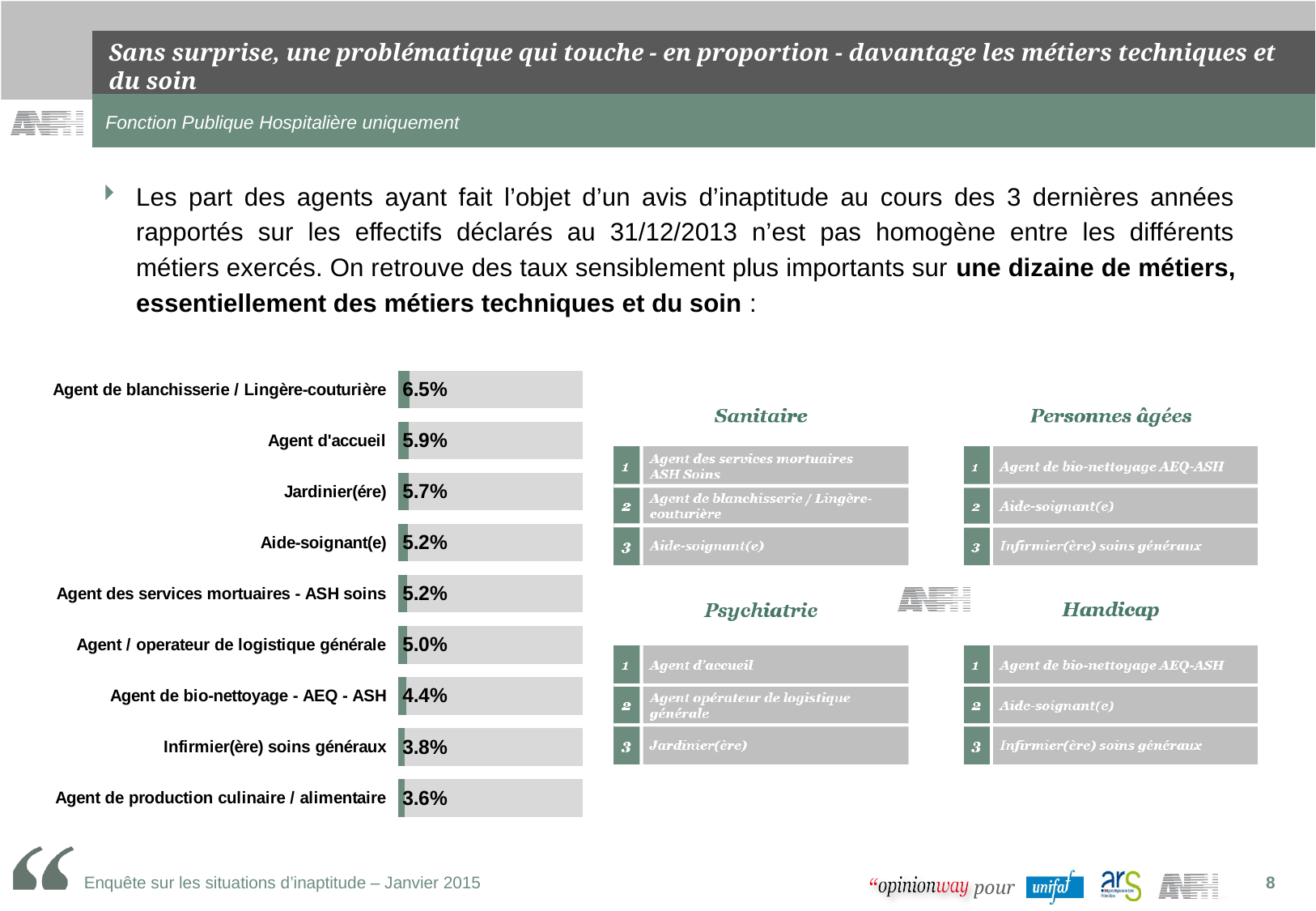
Which category has the lowest value in the bar chart? Agent de production culinaire / alimentaire Which category has the highest value in the bar chart? Agent de blanchisserie / Lingère-couturière Which has a larger value, Agent d'accueil or Aide-soignant(e)? Agent d'accueil How many categories are shown in the bar chart? 9 What is the value shown for Infirmier(ère) soins généraux? 3.8% What is the difference between the values for Jardinier(ére) and Infirmier(ère) soins généraux? 1.9% What is the difference between the values for Agent de blanchisserie / Lingère-couturière and Agent de production culinaire / alimentaire? 2.9% What is the value shown for Agent de blanchisserie / Lingère-couturière? 6.5% What is the value shown for Agent d'accueil? 5.9% Do the values in the bar chart increase or decrease from the top category to the bottom category? Decrease What kind of chart is shown on the left of the slide? Bar chart What is the value shown for Agent de bio-nettoyage - AEQ - ASH? 4.4%